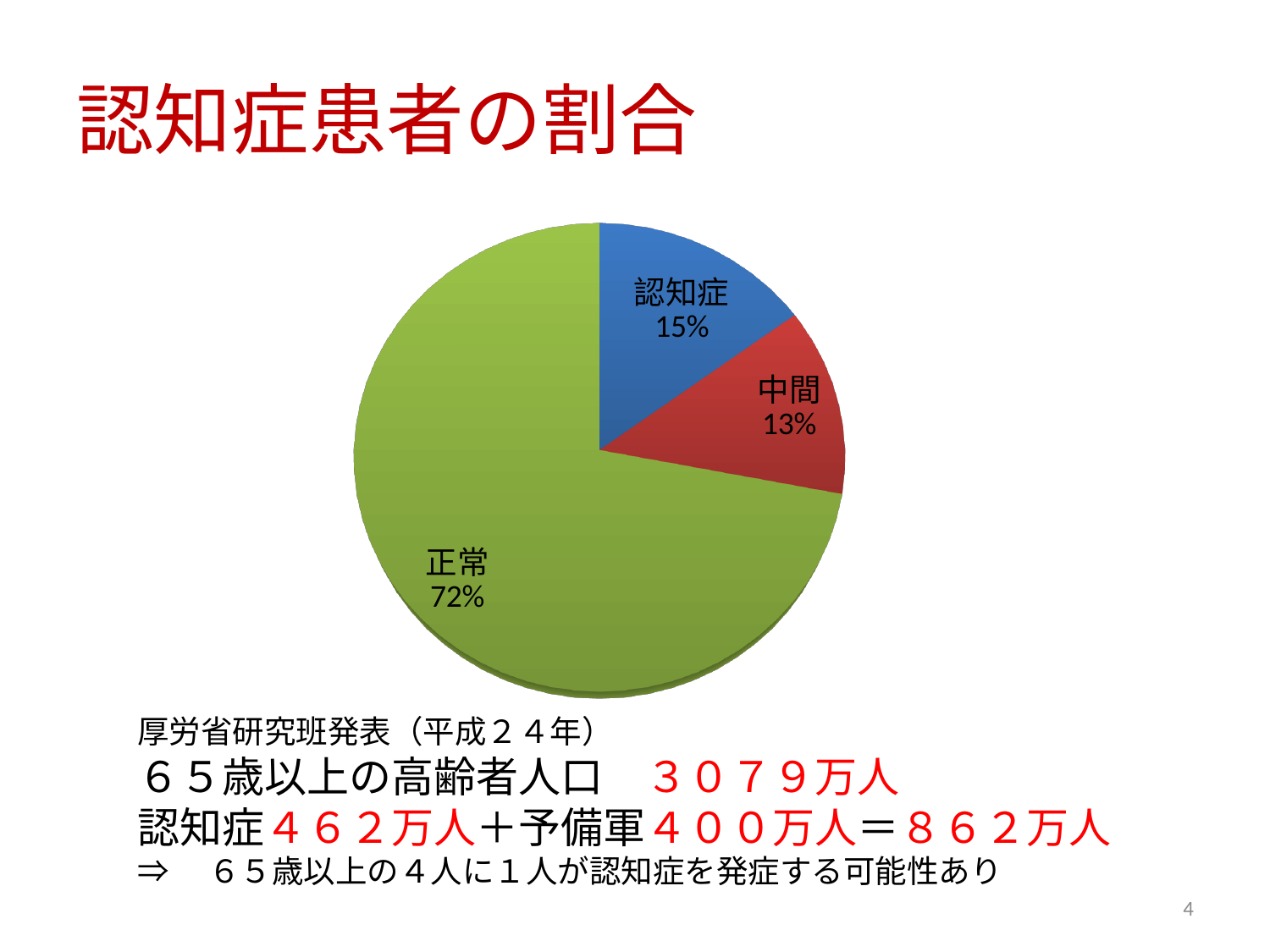
What percentage does the 正常 slice show? 72% What is the difference in percentage points between the 正常 slice and the 認知症 slice? 57 What is the difference in percentage points between the 認知症 slice and the 中間 slice? 2 Which is larger, the 認知症 slice or the 中間 slice? 認知症 What percentage does the 中間 slice show? 13% What is the combined share of the 認知症 and 中間 slices? 28% How many slices does the pie chart have? 3 Which slice of the pie is the largest? 正常 What percentage does the 認知症 slice show? 15% What colour is the 正常 slice? green What kind of chart is shown on the slide? pie chart Which slice of the pie is the smallest? 中間